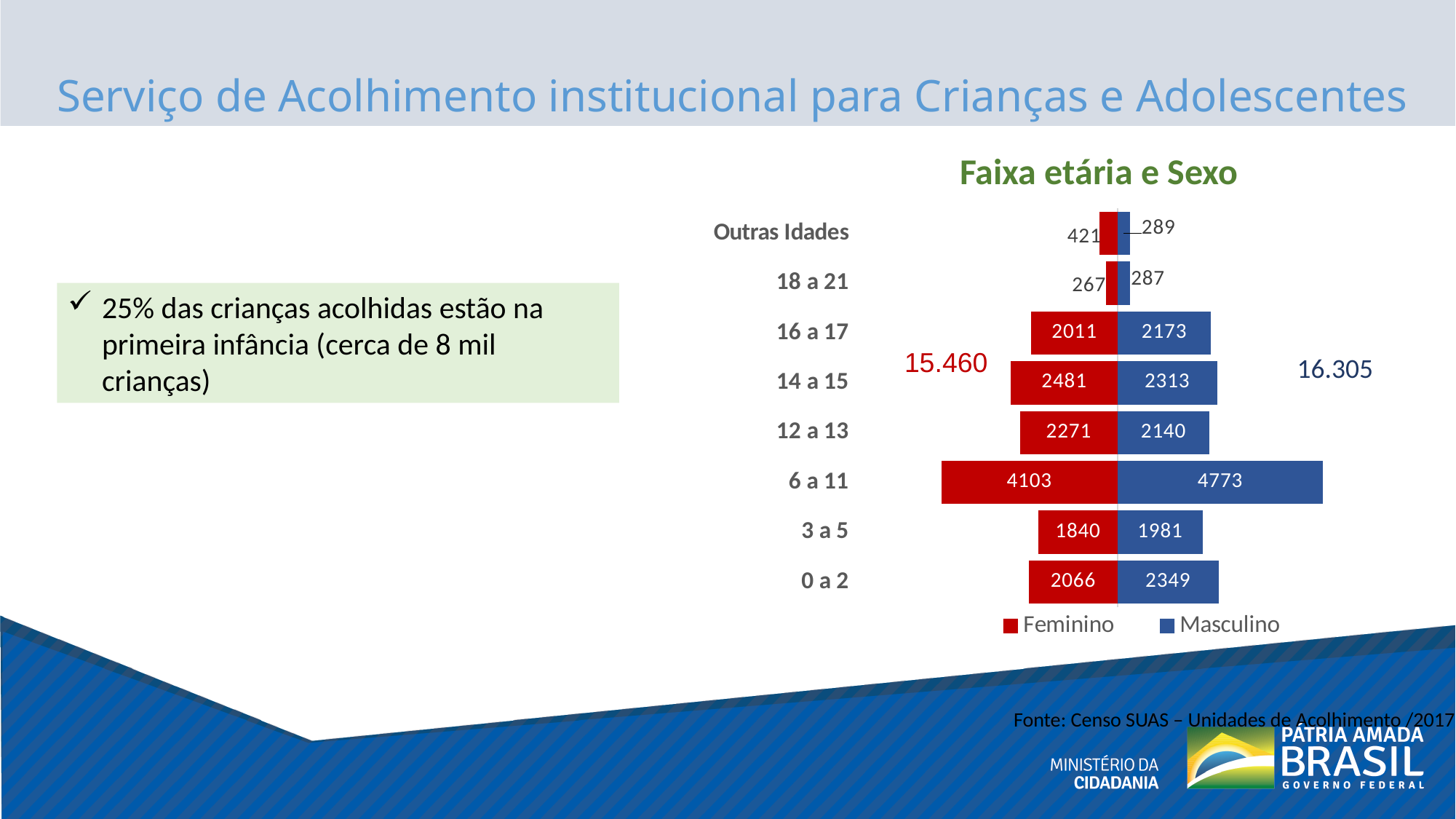
Which age group has the highest Masculino value? 6 a 11 What kind of chart is shown on the slide? Bar chart Which is larger for the 14 a 15 age group, the Feminino value or the Masculino value? Feminino How many age groups are shown in the chart? 8 What is the difference between the Masculino and Feminino values for the 6 a 11 age group? 670 What is the Masculino value for the 0 a 2 age group? 2349 Which is larger for the 3 a 5 age group, the Feminino value or the Masculino value? Masculino What is the Feminino value for the 14 a 15 age group? 2481 How many series does the legend list? 2 What is the title of the chart? Faixa etária e Sexo Which age group has the lowest Feminino value? 18 a 21 What is the Feminino value for the 6 a 11 age group? 4103